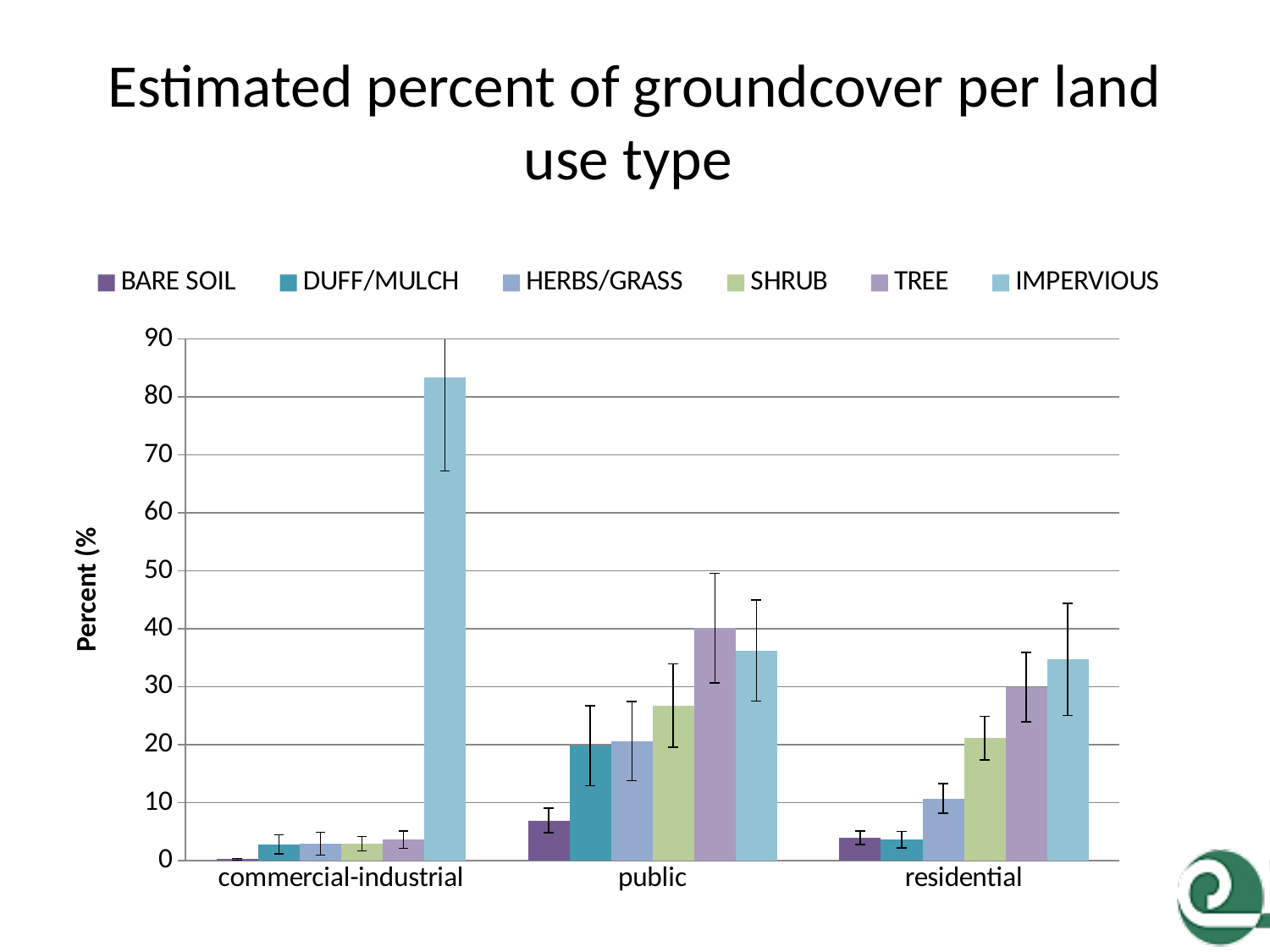
Is the SHRUB value for residential greater or less than 30? less Is the TREE value for public greater or less than 30? greater Is the IMPERVIOUS value for commercial-industrial greater or less than 80? greater Which groundcover series has the lowest value for the public land use type? BARE SOIL For the public land use type, which is larger: TREE or IMPERVIOUS? TREE What is the title of the chart? Estimated percent of groundcover per land use type For the residential land use type, which is larger: TREE or SHRUB? TREE How many land use types are shown on the x axis? 3 How many series does the legend list? 6 What kind of chart is shown on the slide? bar chart Which land use type has the highest IMPERVIOUS value? commercial-industrial